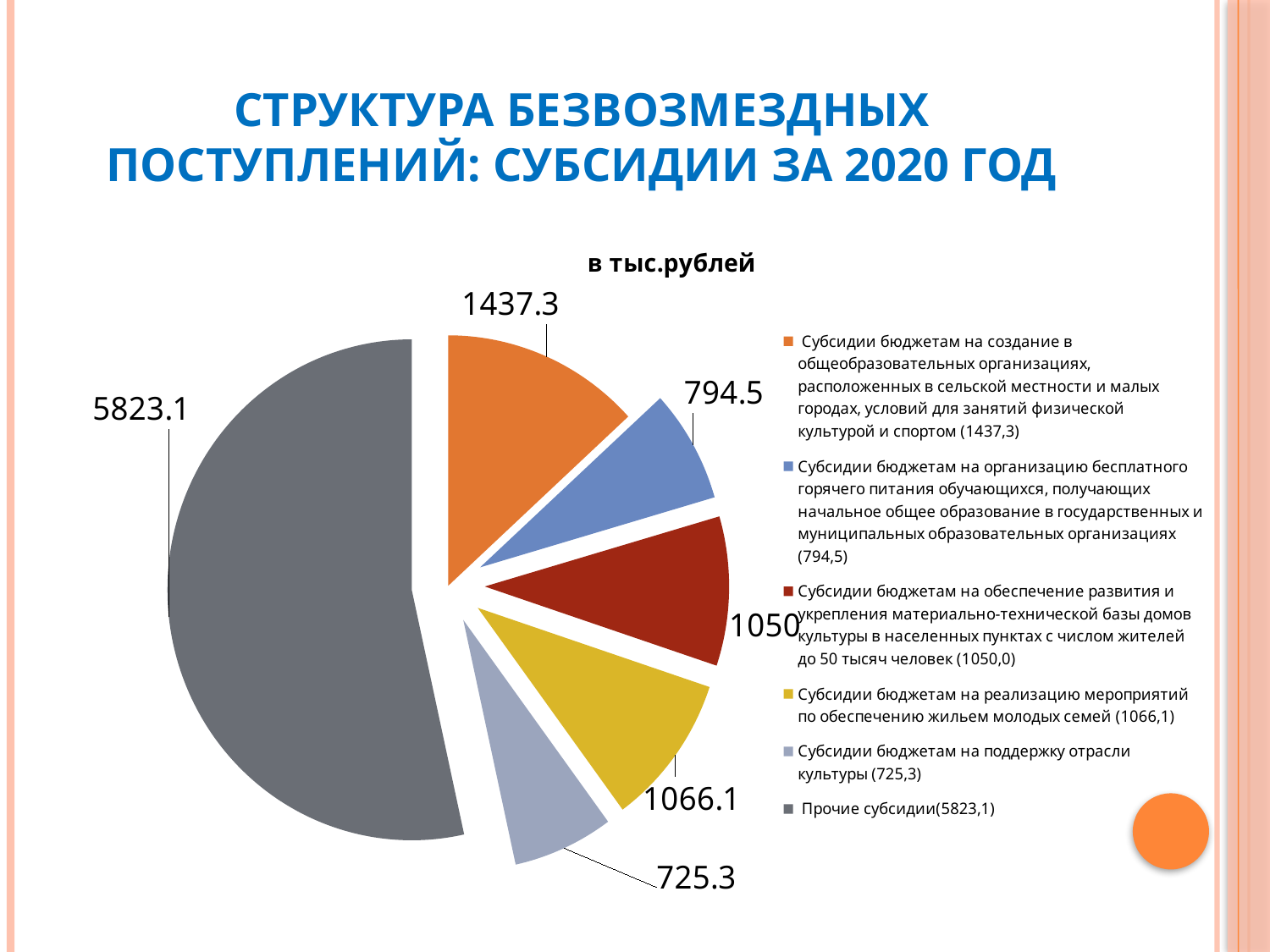
Which is larger: the slice for physical culture and sport in rural schools or the slice for free hot meals? physical culture and sport in rural schools (1437.3) What is the value of the slice for 'Прочие субсидии'? 5823.1 What is the difference between the slice for physical culture and sport in rural schools (1437.3) and the slice for free hot meals (794.5)? 642.8 Which slice of the pie chart is the smallest? Субсидии бюджетам на поддержку отрасли культуры How many entries does the legend of the pie chart list? 6 What kind of chart is shown on the slide? pie chart What is the value of the slice for 'Субсидии бюджетам на поддержку отрасли культуры'? 725.3 What is the value of the slice for subsidies for providing housing to young families ('обеспечению жильем молодых семей')? 1066.1 Which slice of the pie chart is the largest? Прочие субсидии What is the value of the slice for subsidies for free hot meals for primary school students ('бесплатного горячего питания')? 794.5 What unit is stated in the title of the pie chart? в тыс.рублей How many slices does the pie chart have? 6